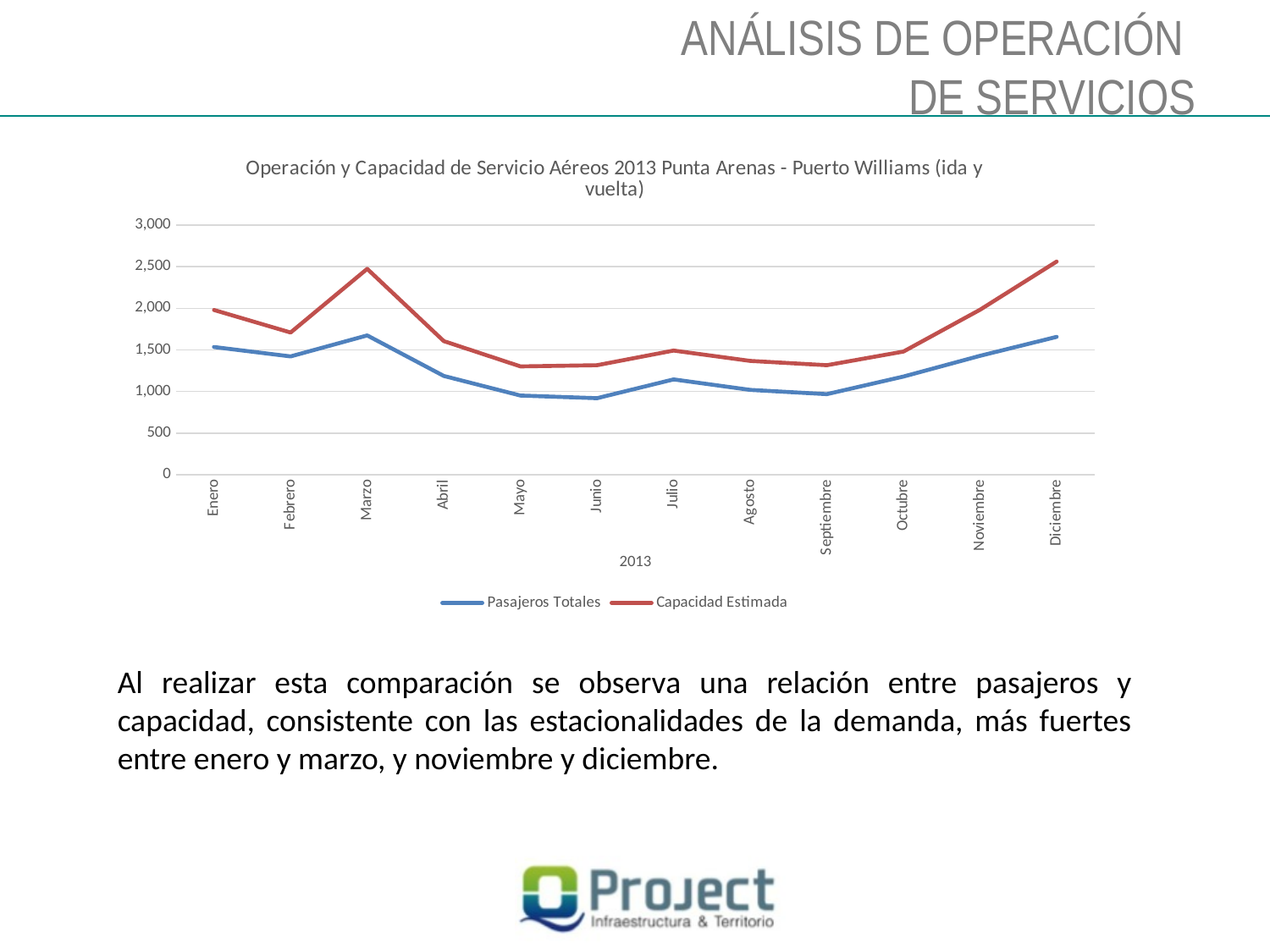
How many series does the legend list? 2 In Marzo, which series has the larger value, Pasajeros Totales or Capacidad Estimada? Capacidad Estimada What kind of chart is shown on the slide? line chart Is the value of Pasajeros Totales for Junio greater or less than 1,000? less How many months are plotted along the x axis? 12 Do the values of Pasajeros Totales rise or fall from Septiembre to Diciembre? rise Do the values of Capacidad Estimada rise or fall from Marzo to Mayo? fall Is the value of Pasajeros Totales for Abril greater or less than 1,000? greater Which series is drawn in red? Capacidad Estimada Is the value of Capacidad Estimada for Abril greater or less than 1,500? greater